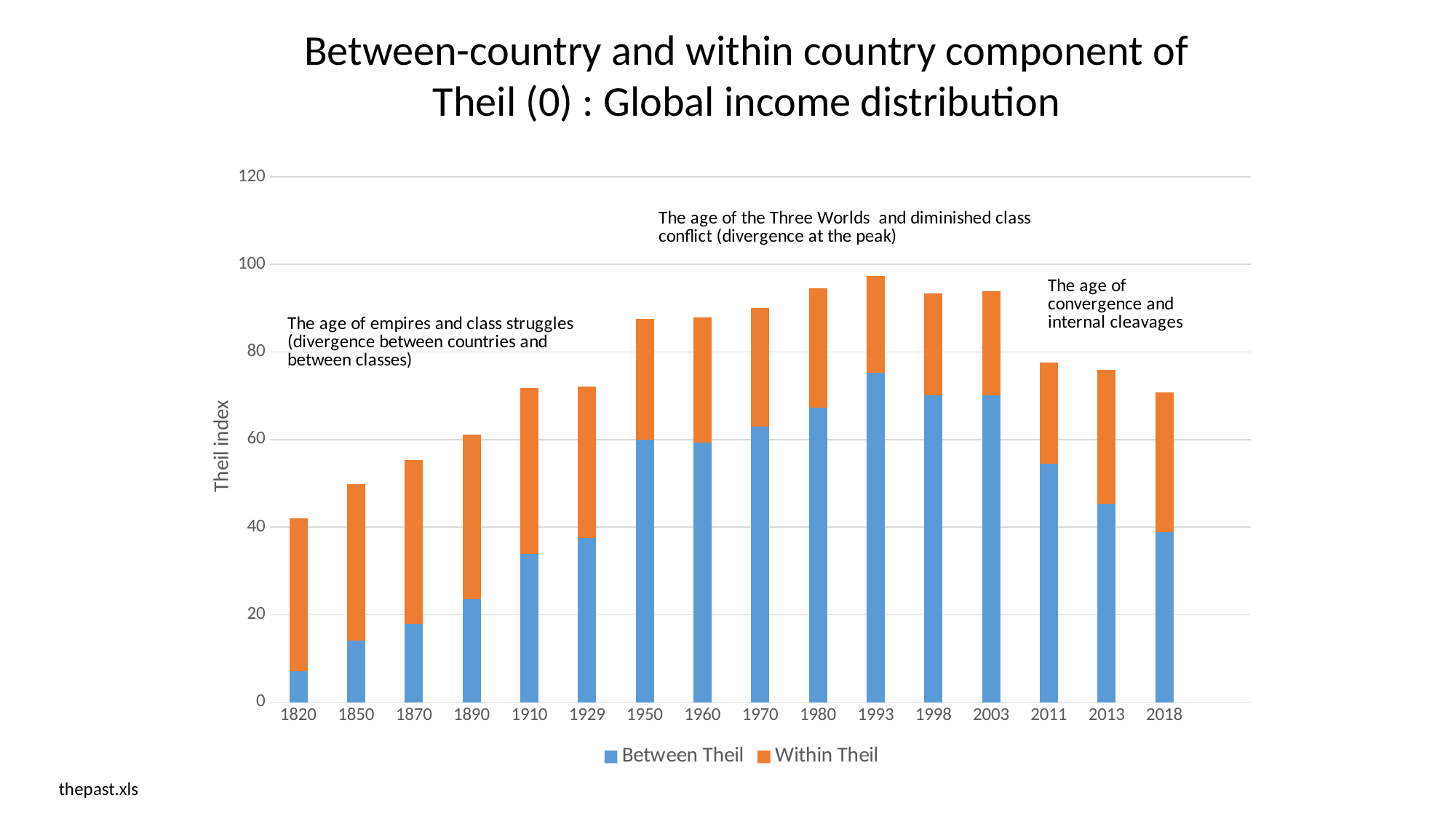
How many years are shown on the x axis of the chart? 16 How many series does the legend list? 2 Which year has a larger total Theil index, 1820 or 2018? 2018 Which year has the highest total Theil index (tallest stacked bar)? 1993 Which year has the smallest Between Theil component? 1820 What is the label of the y axis? Theil index Is the total Theil index for 1993 greater or less than 80? greater What kind of chart is shown on the slide? stacked bar chart Is the Between Theil value for 1820 greater or less than 20? less Is the total Theil index for 1850 greater or less than 60? less Does the total Theil index rise or fall from 1993 to 2018? fall Which year has the lowest total Theil index (shortest stacked bar)? 1820